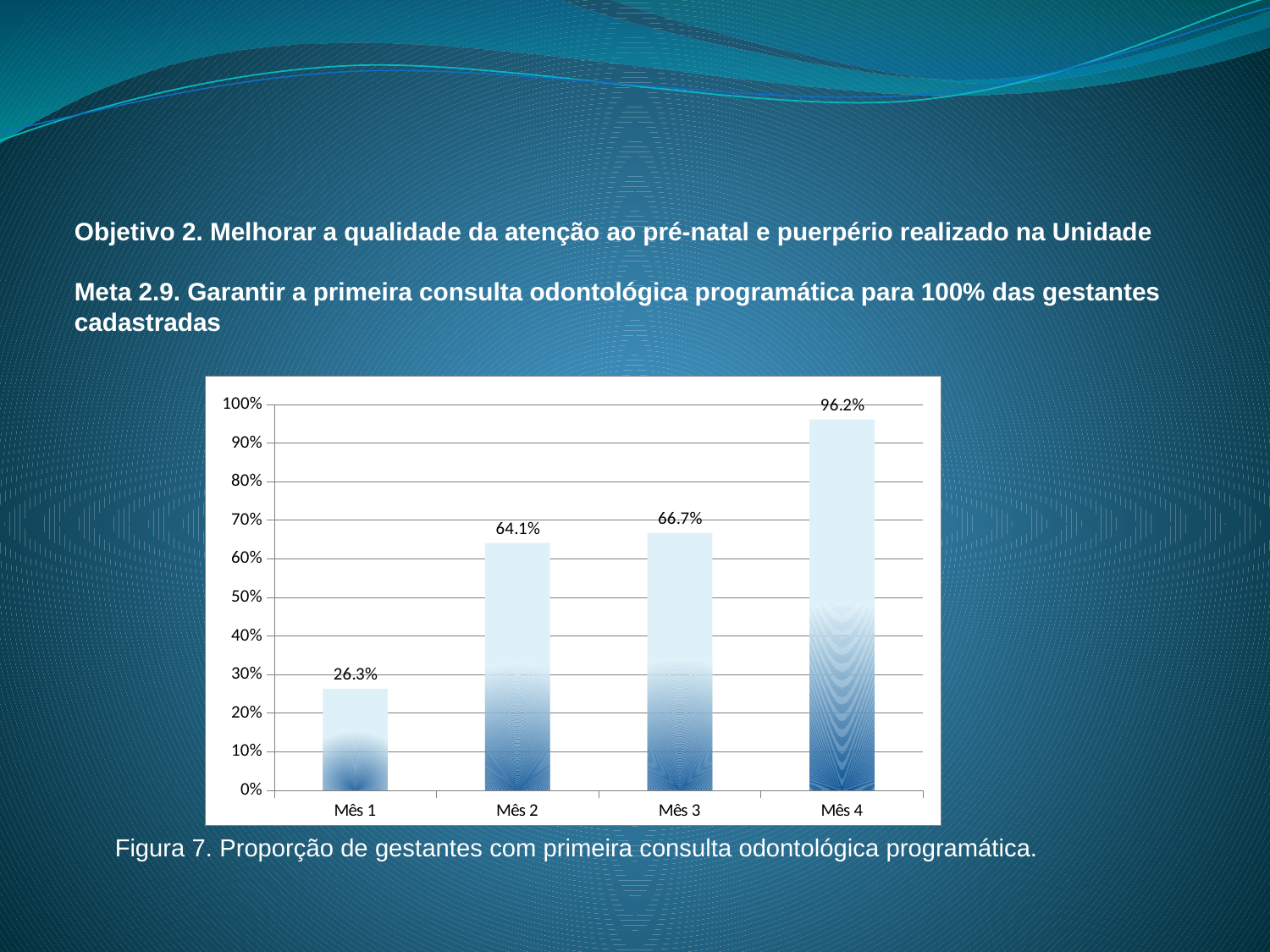
How many months are shown on the x axis? 4 What is the difference between the values for Mês 3 and Mês 2? 2.6% What is the value for Mês 3? 66.7% What kind of chart is shown on the slide? Bar chart Which month has the highest value? Mês 4 Which is larger, the value for Mês 2 or the value for Mês 4? Mês 4 What is the value for Mês 4? 96.2% Do the values rise or fall from Mês 1 to Mês 4? Rise What is the value for Mês 1? 26.3% What is the value for Mês 2? 64.1% Which month has the lowest value? Mês 1 What is the difference between the values for Mês 4 and Mês 1? 69.9%